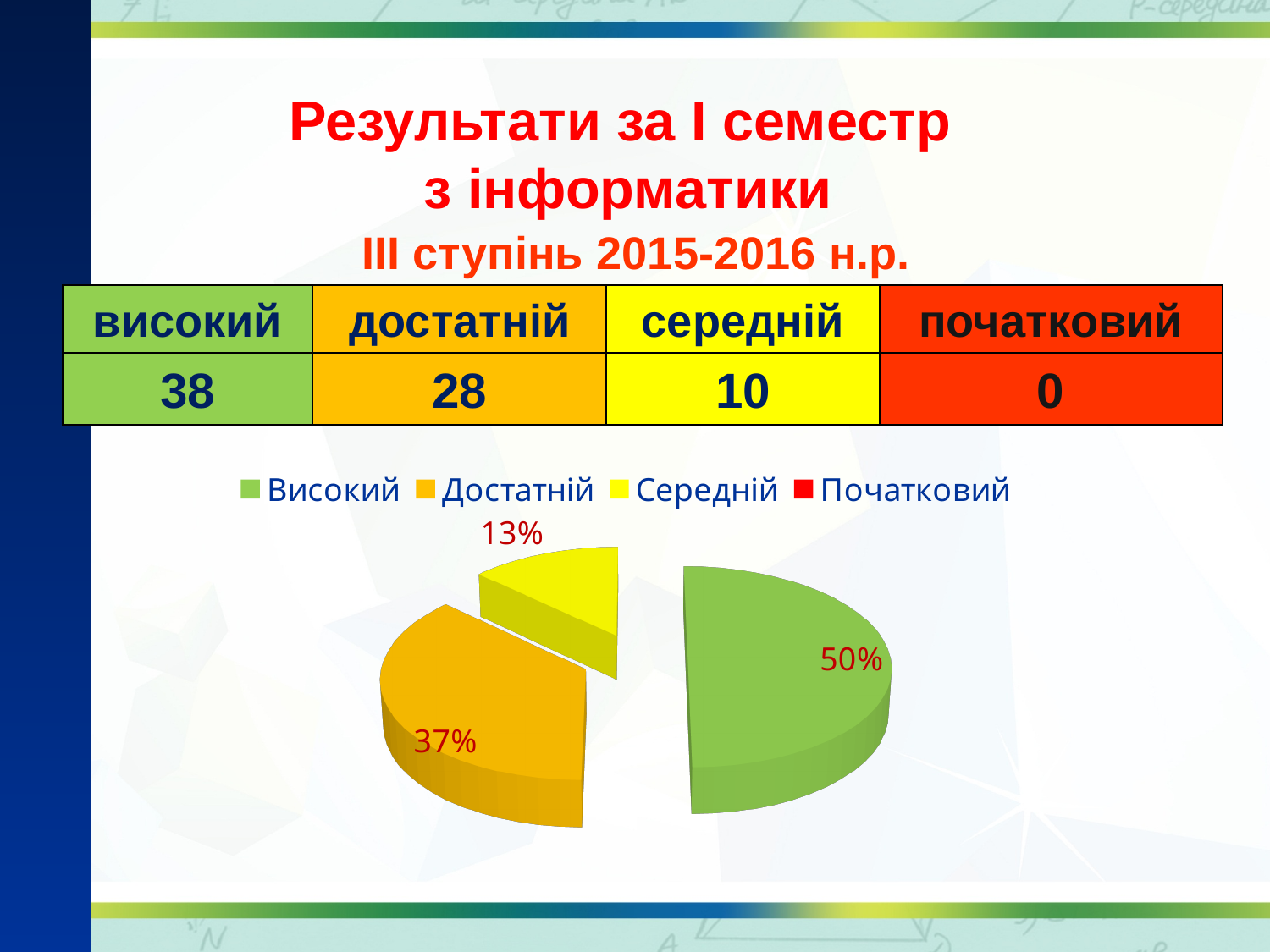
Which slice is larger in the pie chart, Достатній or Середній? Достатній What percentage does the pie chart show for Середній? 13% How many percentage labels are shown on the pie chart? 3 What percentage does the pie chart show for Достатній? 37% How many entries does the pie chart legend list? 4 Which category with a visible slice has the smallest share in the pie chart? Середній What percentage does the pie chart show for Високий? 50% Which category has the largest slice in the pie chart? Високий What is the difference in percentage points between the Високий and Достатній slices? 13% Which legend entry is shown in red in the pie chart legend? Початковий What type of chart is shown on the slide? pie chart What colour is the Високий slice in the pie chart? green